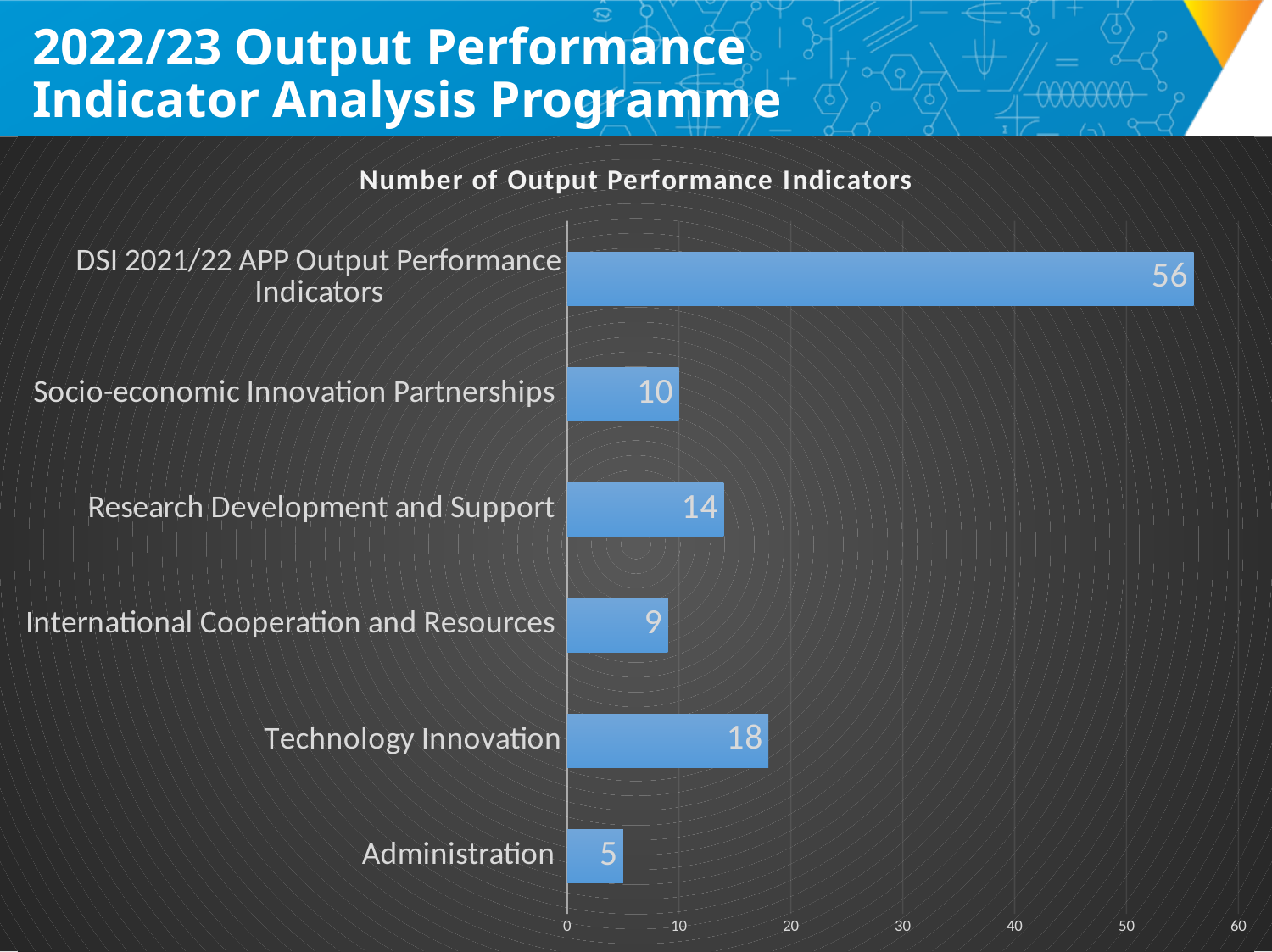
Is the value for DSI 2021/22 APP Output Performance Indicators greater or less than 50? greater What is the value for DSI 2021/22 APP Output Performance Indicators? 56 What is the title of the chart? Number of Output Performance Indicators What is the value for Administration? 5 What is the difference between the values for Technology Innovation and Socio-economic Innovation Partnerships? 8 Which category has the highest value? DSI 2021/22 APP Output Performance Indicators Which is larger, the value for Research Development and Support or the value for International Cooperation and Resources? Research Development and Support What is the value for Technology Innovation? 18 What is the value for Research Development and Support? 14 How many categories are shown in the chart? 6 What kind of chart is shown on the slide? bar chart Which category has the lowest value? Administration